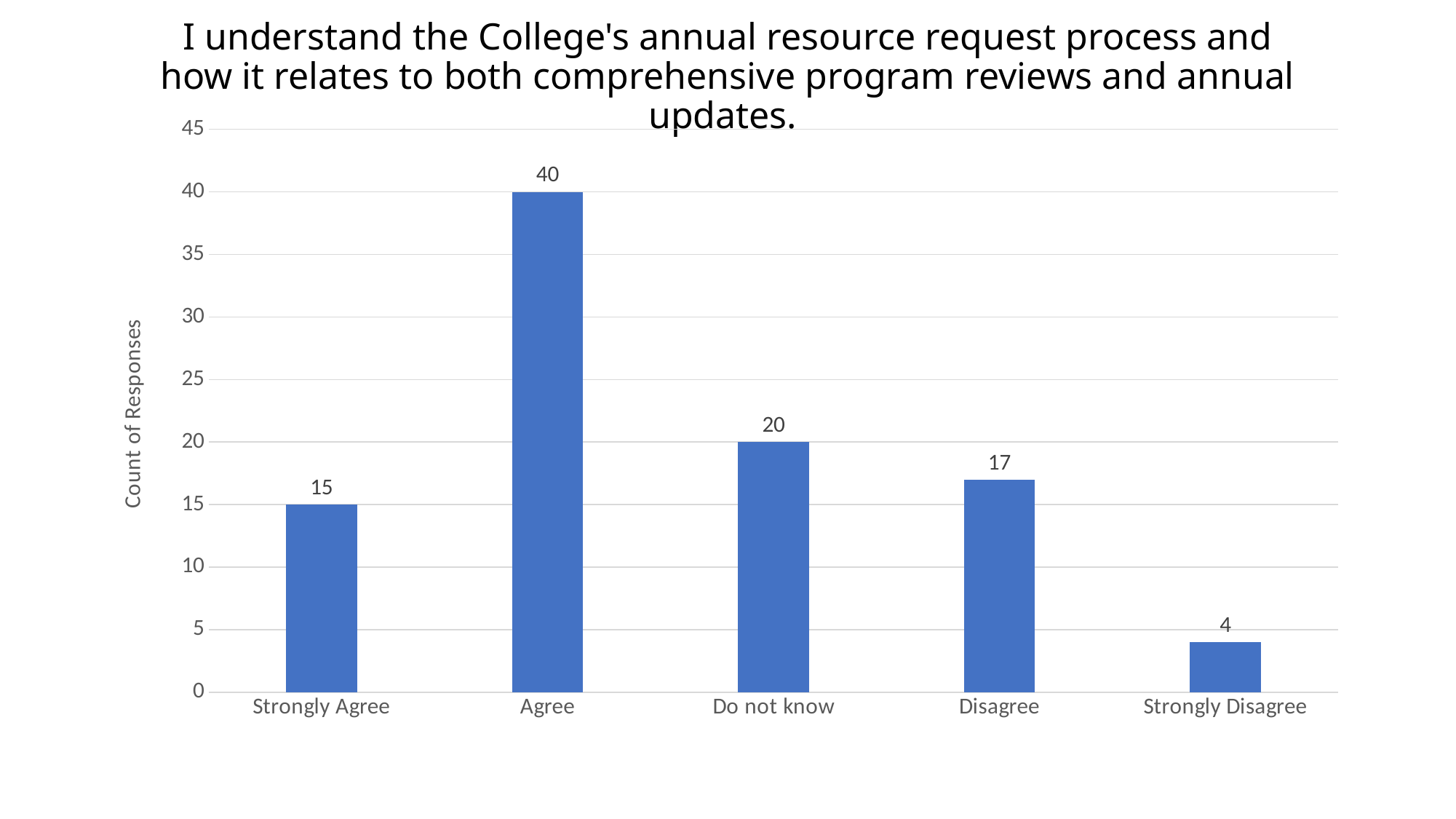
What is the difference between the counts for Do not know and Disagree? 3 Which has a higher count, Strongly Agree or Disagree? Disagree Which response category has the highest count? Agree How many response categories are shown on the x axis? 5 What is the count of responses for Agree? 40 What is the count of responses for Strongly Disagree? 4 What is the count of responses for Do not know? 20 What is the difference between the counts for Agree and Strongly Agree? 25 What kind of chart is shown on the slide? Bar chart Which response category has the lowest count? Strongly Disagree What is the label of the vertical axis? Count of Responses Is the value for Disagree greater or less than 15? greater